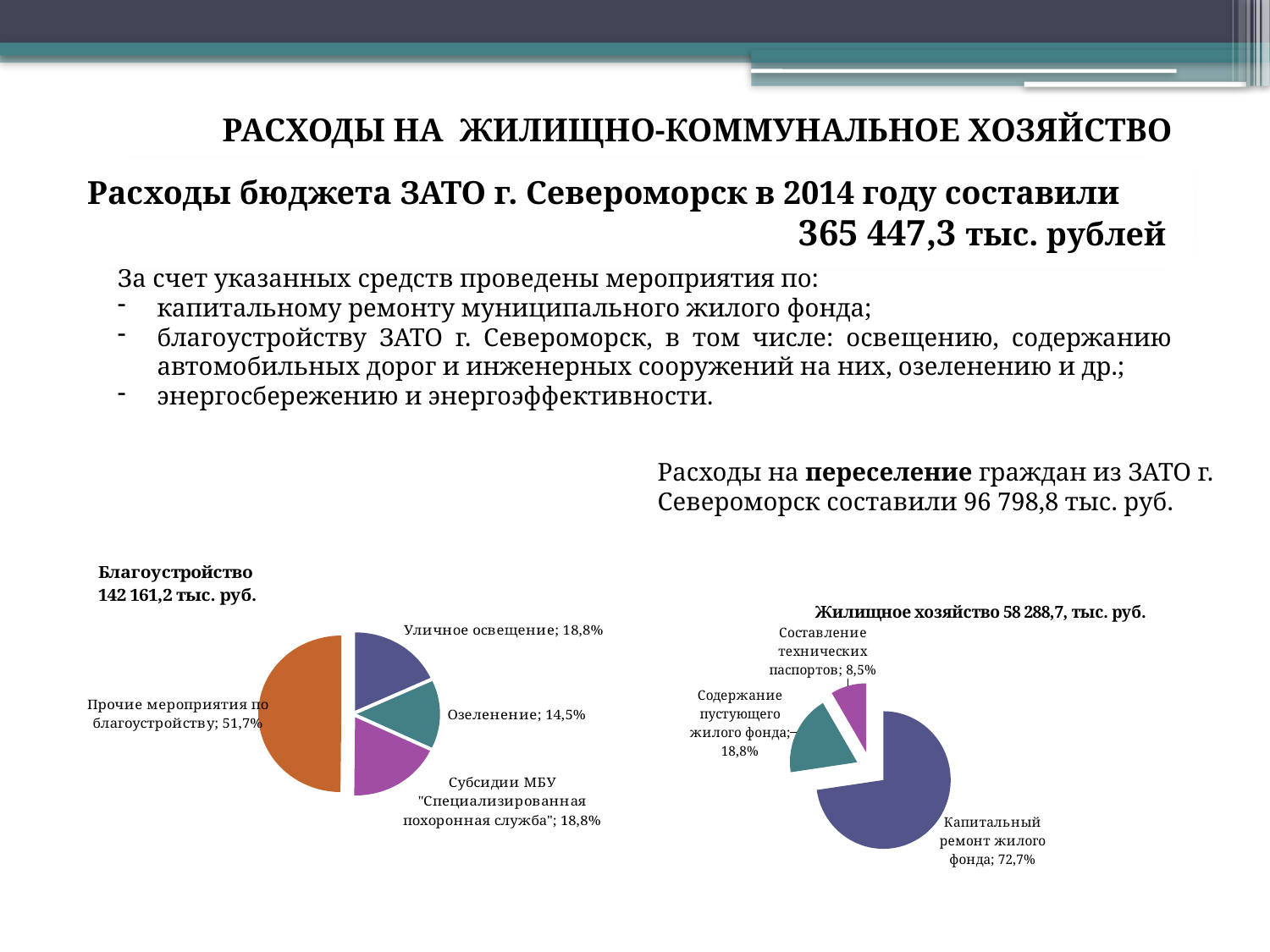
На диаграмме «Жилищное хозяйство» какая категория имеет наименьшую долю? Составление технических паспортов Сколько секторов на диаграмме «Жилищное хозяйство»? 3 Сколько секторов на диаграмме «Благоустройство»? 4 Какого типа диаграмма «Жилищное хозяйство»? Круговая диаграмма На диаграмме «Благоустройство» на сколько процентных пунктов доля прочих мероприятий по благоустройству больше доли озеленения? 37,2 На диаграмме «Благоустройство» какая доля приходится на озеленение? 14,5% На диаграмме «Благоустройство» какая доля приходится на уличное освещение? 18,8% На диаграмме «Жилищное хозяйство» какая доля приходится на капитальный ремонт жилого фонда? 72,7% На диаграмме «Благоустройство» какая категория имеет наименьшую долю? Озеленение На диаграмме «Жилищное хозяйство» что больше: доля содержания пустующего жилого фонда или доля составления технических паспортов? Содержание пустующего жилого фонда На диаграмме «Благоустройство» какая категория имеет наибольшую долю? Прочие мероприятия по благоустройству На диаграмме «Жилищное хозяйство» какая доля приходится на составление технических паспортов? 8,5%